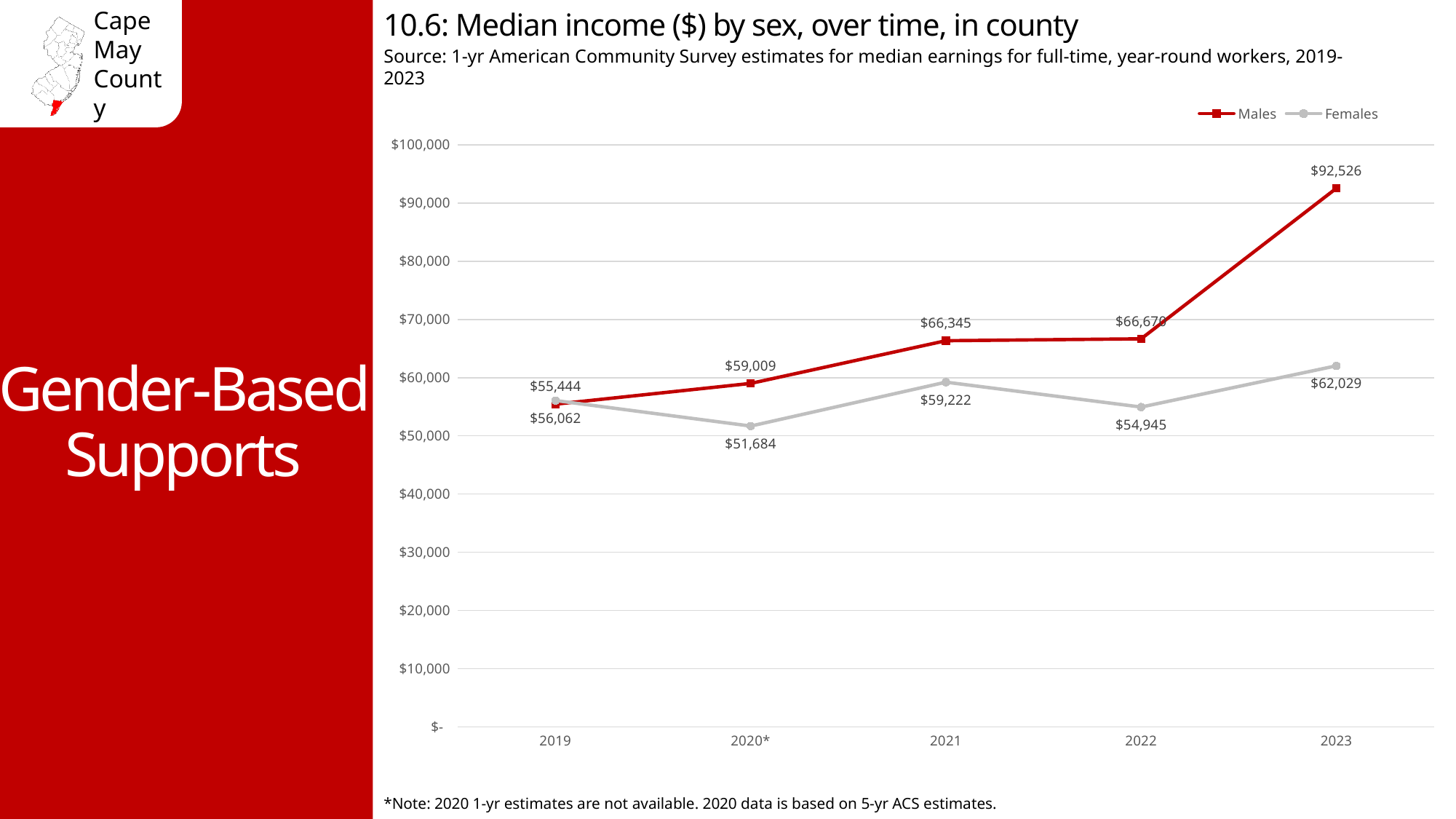
What is the median income for Females in 2022? $54,945 Which series has the higher median income in 2019, Males or Females? Females In which year is the Females median income lowest? 2020* What is the median income for Males in 2023? $92,526 What is the median income for Males in 2021? $66,345 How many years are shown on the x axis? 5 What is the difference between the Males and Females median income in 2023? $30,497 What is the median income for Females in 2020*? $51,684 Does the Males median income rise or fall from 2019 to 2023? Rise In which year is the Males median income highest? 2023 How many series does the legend list? 2 What kind of chart is shown on the slide? Line chart